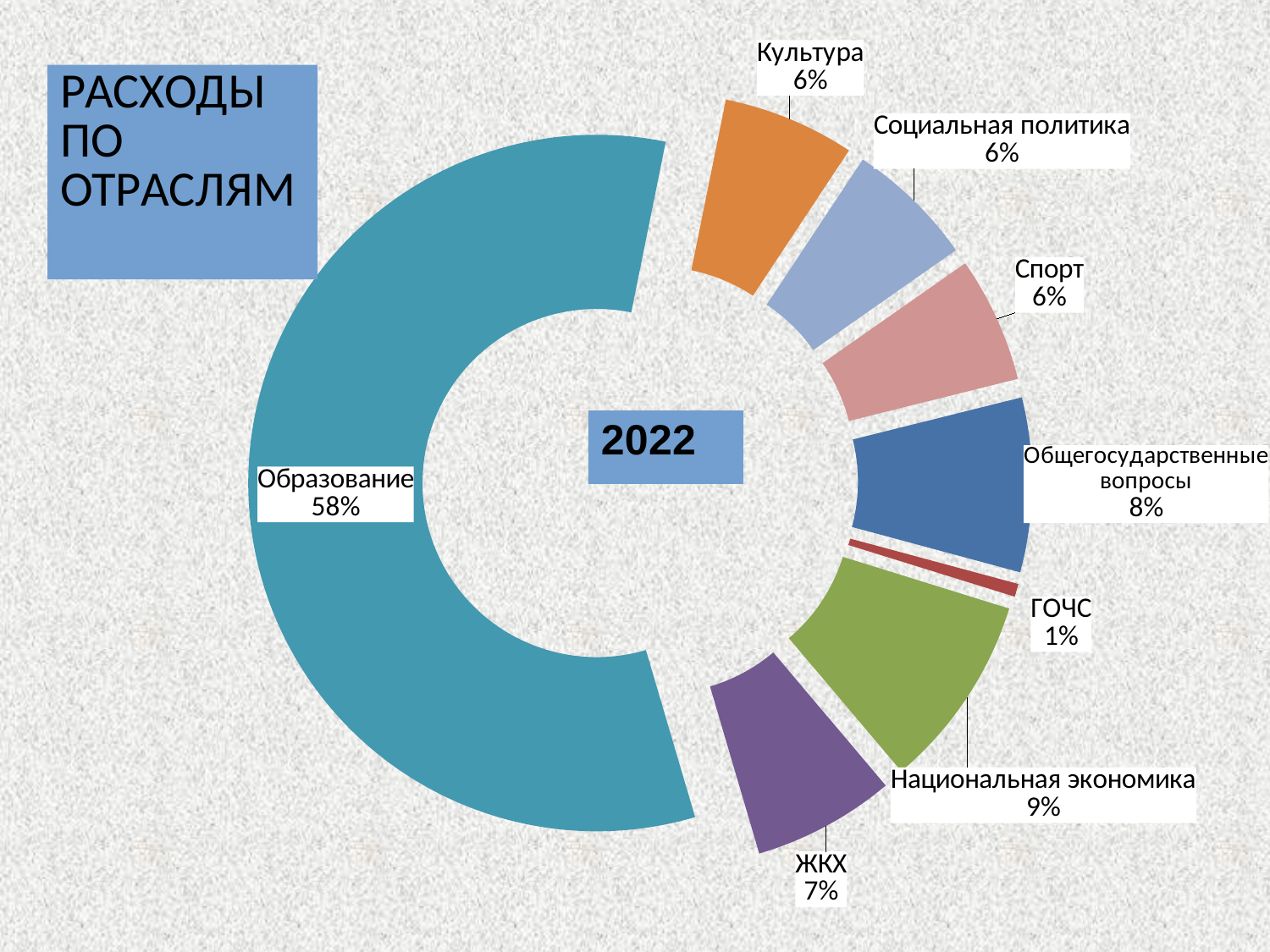
What share of expenditures does Образование account for? 58% Which category has the largest share of expenditures? Образование How many categories are shown in the chart? 8 Which is larger, the share for Общегосударственные вопросы or the share for ЖКХ? Общегосударственные вопросы What is the value for ЖКХ? 7% What is the value for ГОЧС? 1% What kind of chart is shown on the slide? Pie (doughnut) chart What year is shown in the centre of the chart? 2022 What is the difference between the shares of Образование and Национальная экономика? 49% What is the value shown for Национальная экономика? 9% What percentage is shown for Общегосударственные вопросы? 8% Which category has the smallest share of expenditures? ГОЧС